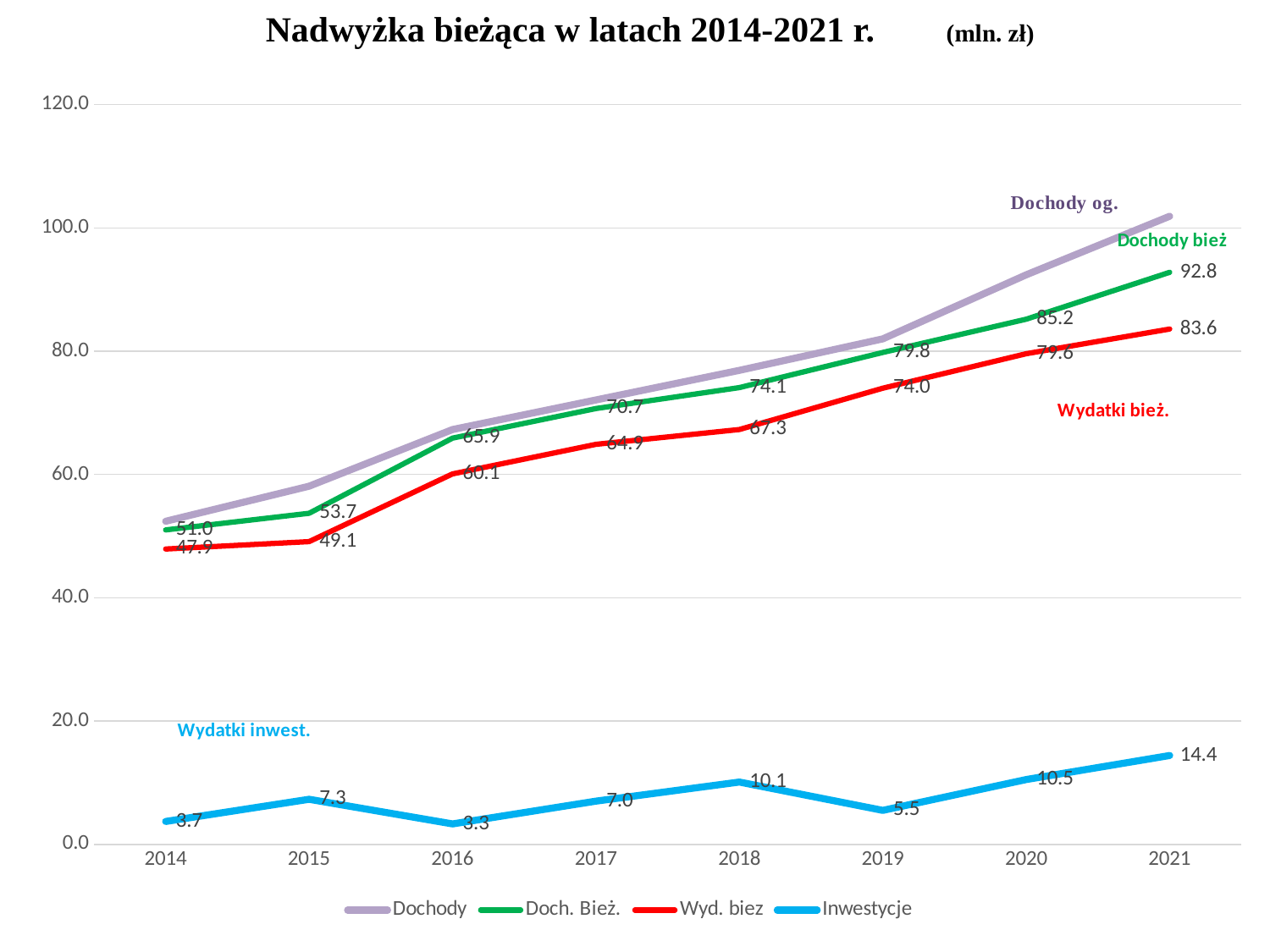
Does the Wyd. biez series rise or fall from 2014 to 2021? rise In which year is Inwestycje lowest? 2016 What type of chart is shown on the slide? line chart What is the difference between Doch. Bież. and Wyd. biez in 2021? 9.2 In which year is Doch. Bież. highest? 2021 Is the value for Dochody in 2021 greater or less than 100.0? greater How many series does the legend list? 4 What is the value of Doch. Bież. in 2021? 92.8 Which is larger in 2018: Doch. Bież. or Wyd. biez? Doch. Bież. How many years are shown on the x axis? 8 What is the value of Inwestycje in 2019? 5.5 What is the value of Wyd. biez in 2016? 60.1